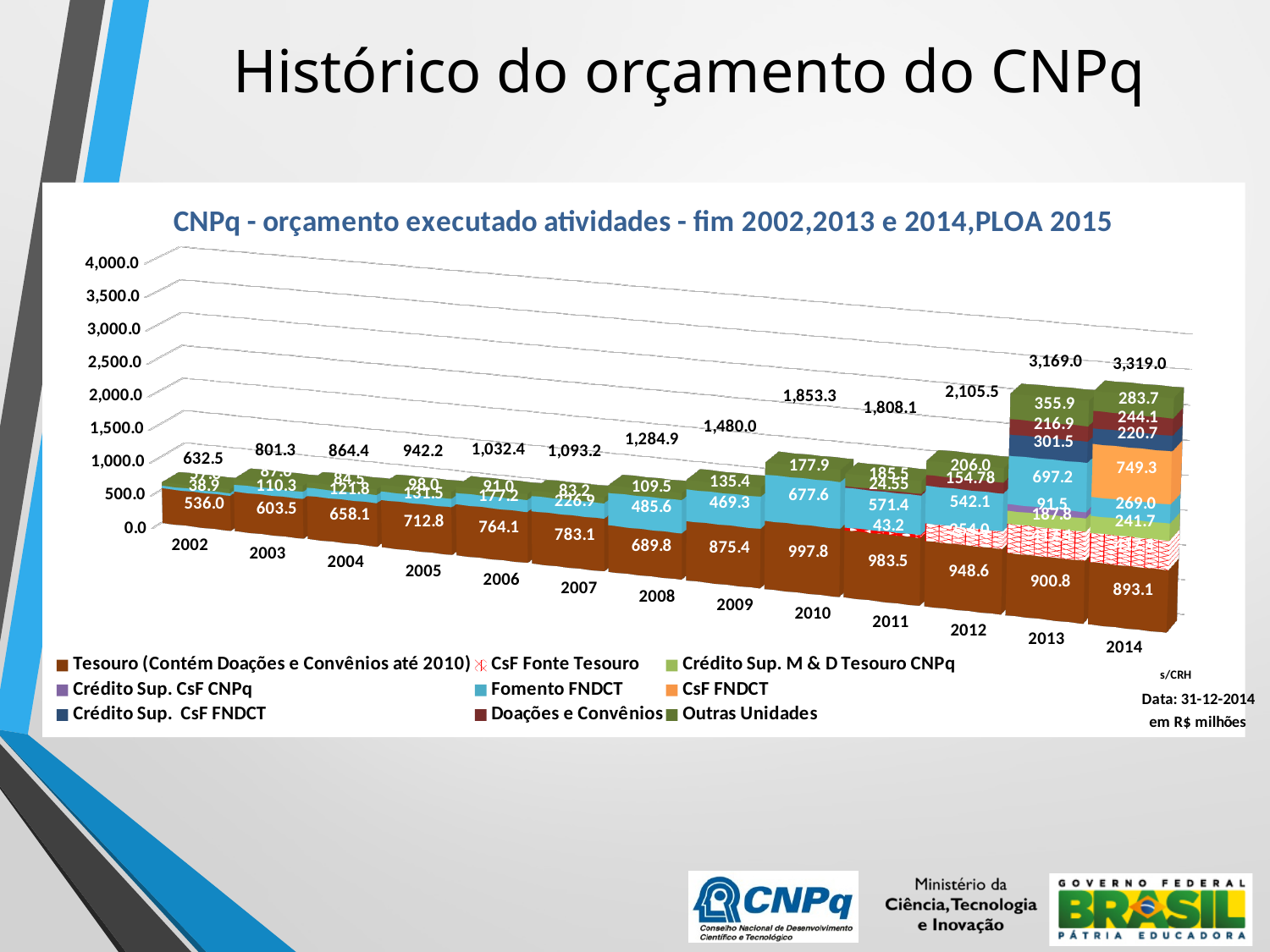
What is the value of the Fomento FNDCT segment for 2013? 697.2 What kind of chart is shown on the slide? Stacked bar chart Which year has the lowest total value? 2002 How many years are shown along the x axis of the chart? 13 Which year has the highest total value? 2014 What is the difference between the total for 2014 and the total for 2013? 150.0 Do the total values generally rise or fall from 2002 to 2014? Rise Which year has the larger Tesouro segment, 2010 or 2011? 2010 What is the title of the chart? CNPq - orçamento executado atividades - fim 2002,2013 e 2014,PLOA 2015 What is the value of the Tesouro segment for 2010? 997.8 How many series does the chart's legend list? 9 What is the total value shown above the bar for 2014? 3,319.0